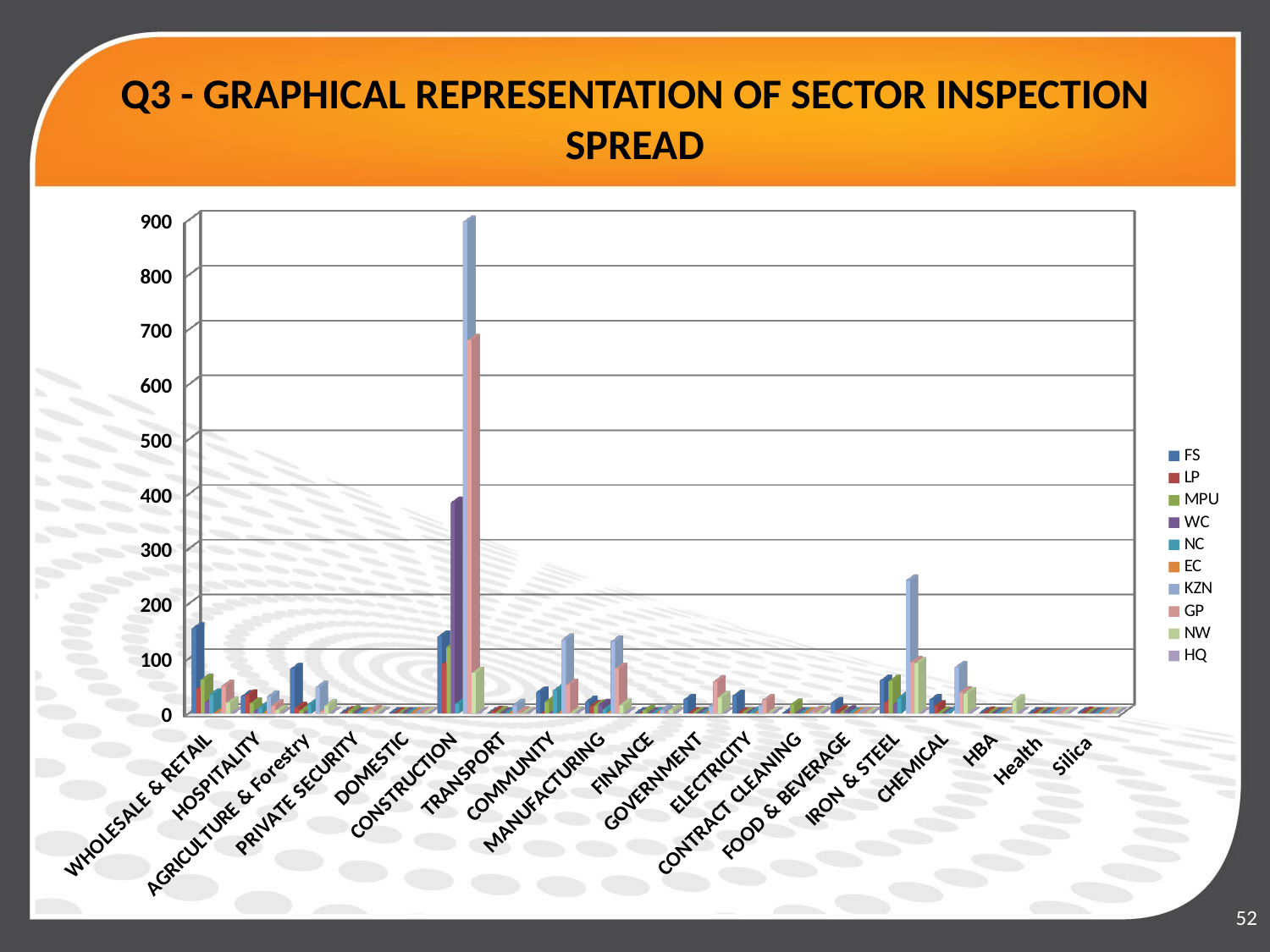
What kind of chart is shown on the slide? bar chart For CONSTRUCTION, which series has the larger value, KZN or GP? KZN How many sector categories are shown along the x axis? 19 Which sector has the tallest bar in the chart? CONSTRUCTION Is the FS value for WHOLESALE & RETAIL greater or less than 100? greater What is the title of the slide containing the chart? Q3 - GRAPHICAL REPRESENTATION OF SECTOR INSPECTION SPREAD How many series does the legend list? 10 Is the WC value for CONSTRUCTION greater or less than 300? greater Which sector has the larger KZN value, IRON & STEEL or CHEMICAL? IRON & STEEL Is the KZN value for CONSTRUCTION greater or less than 800? greater